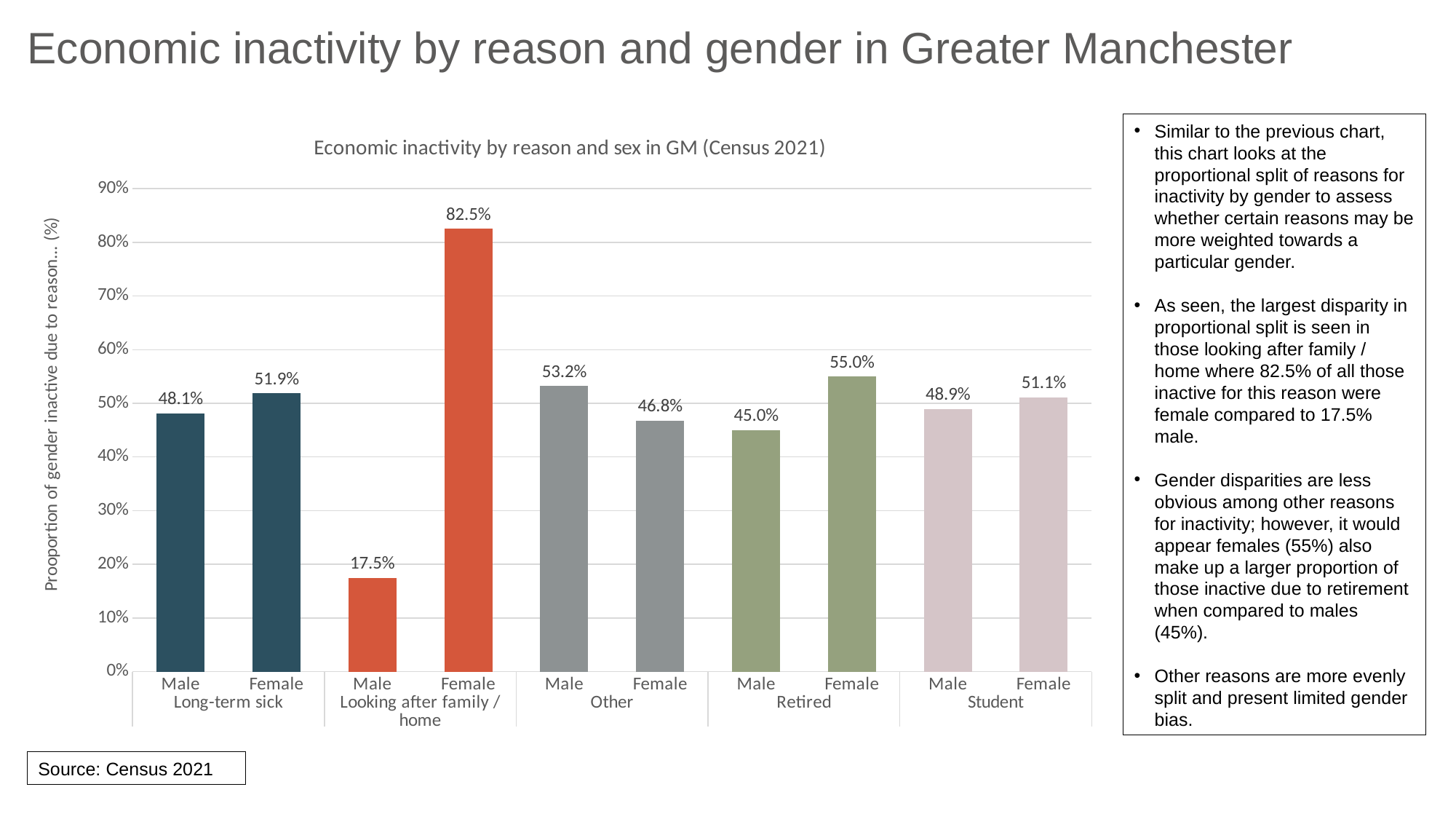
What is the difference between the Female and Male values in the Looking after family / home category? 65.0% How many reason categories are shown on the x axis? 5 What is the difference between the Female and Male values in the Retired category? 10.0% Is the value for Female in the Student category greater or less than 40%? greater Which bar has the lowest value on the chart? Male, Looking after family / home Which is larger, the Male value for Other or the Female value for Other? Male What type of chart is shown on the slide? Bar chart What is the value for Male in the Other category? 53.2% What is the value for Female in the Long-term sick category? 51.9% Which bar has the highest value on the chart? Female, Looking after family / home What is the value for Female in the Looking after family / home category? 82.5% What is the value for Male in the Retired category? 45.0%